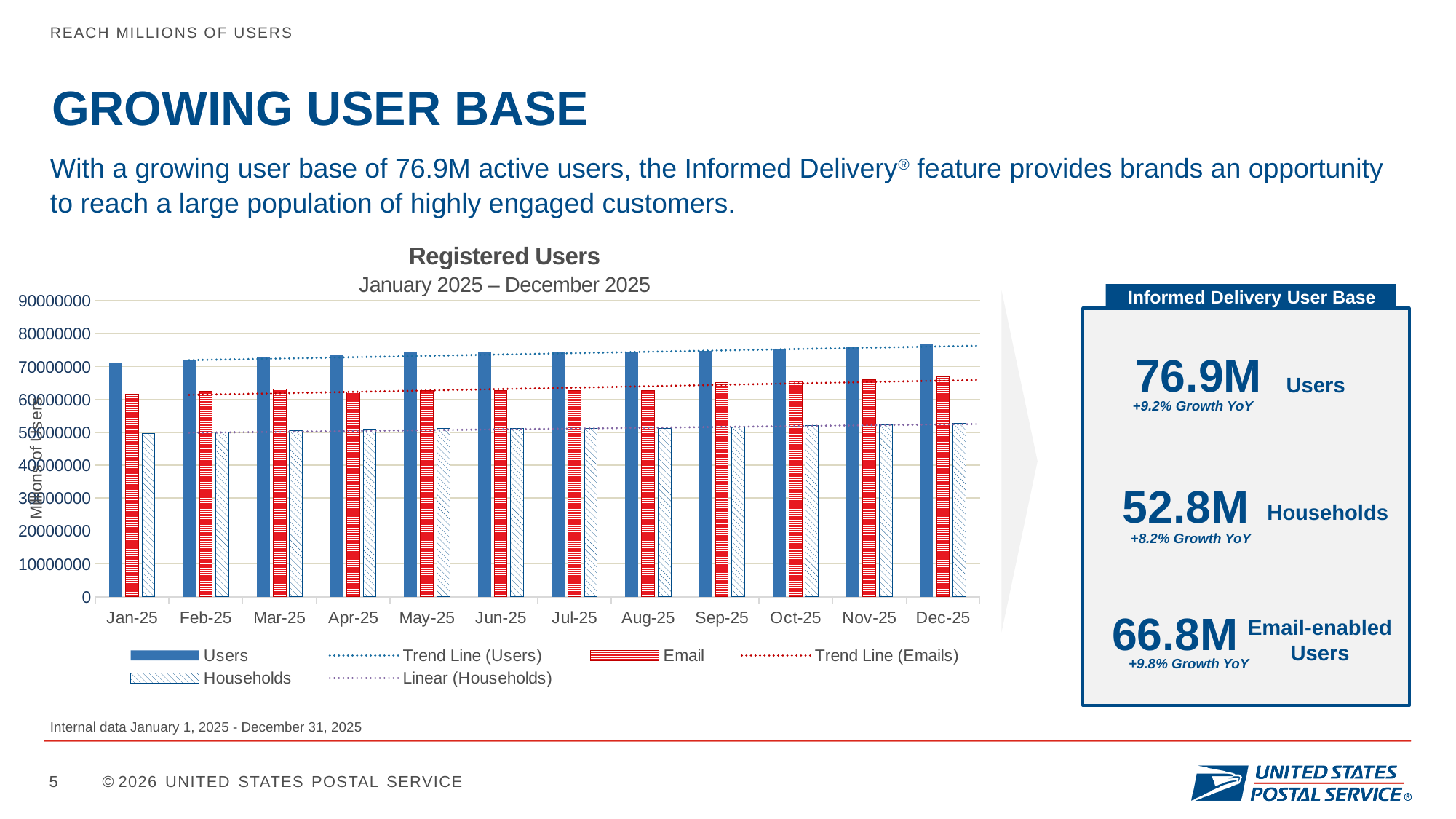
In the Registered Users chart, which month has the lowest Users bar? Jan-25 In the Registered Users chart, is the Email value for Sep-25 greater or less than 60000000? greater How many entries does the legend of the Registered Users chart list? 6 What is the subtitle shown under the title of the Registered Users chart? January 2025 – December 2025 How many months are shown on the x axis of the Registered Users chart? 12 In the Registered Users chart, is the Households value for Dec-25 greater or less than 50000000? greater What kind of chart is the Registered Users chart? bar chart In the Registered Users chart, which month has the highest Users bar? Dec-25 In the Registered Users chart, which series is drawn with solid blue bars? Users In the Registered Users chart, do the Users bars rise or fall from Jan-25 to Dec-25? rise In the Registered Users chart, is the Users value for Dec-25 greater or less than 70000000? greater In the Registered Users chart, which is larger for Jun-25: Users or Households? Users